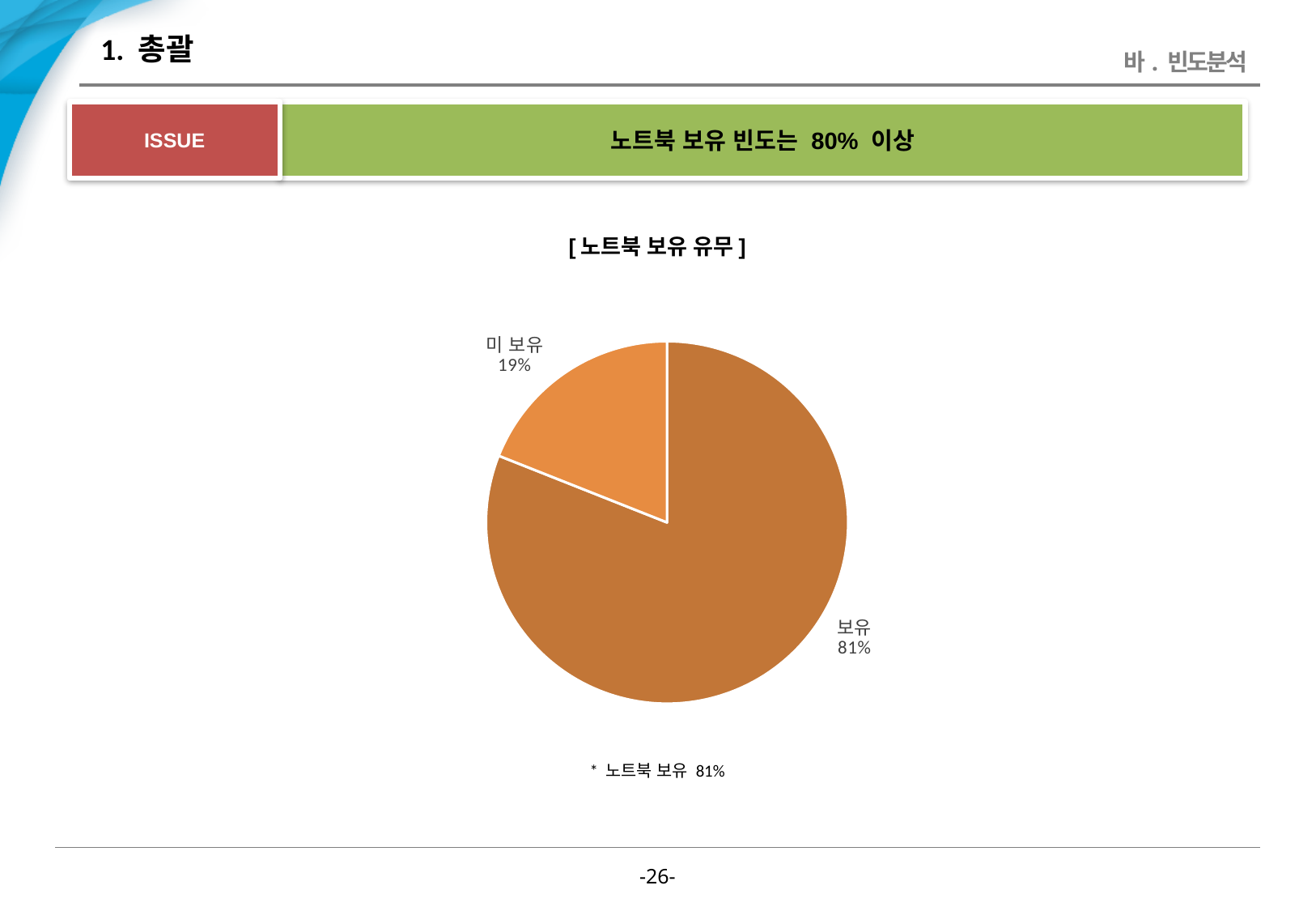
Which slice of the pie chart is the smallest? 미 보유 What is the value for 보유 in the pie chart? 81% What share of the pie does the 미 보유 slice represent? 19% How many slices does the pie chart have? 2 Which slice of the pie chart is the largest? 보유 What is the title of the pie chart? [ 노트북 보유 유무 ] What is the value for 미 보유 in the pie chart? 19% What does the note below the pie chart say? * 노트북 보유 81% Which is larger, 보유 or 미 보유? 보유 What is the difference between the 보유 and 미 보유 shares? 62% What kind of chart is shown on the slide? pie chart